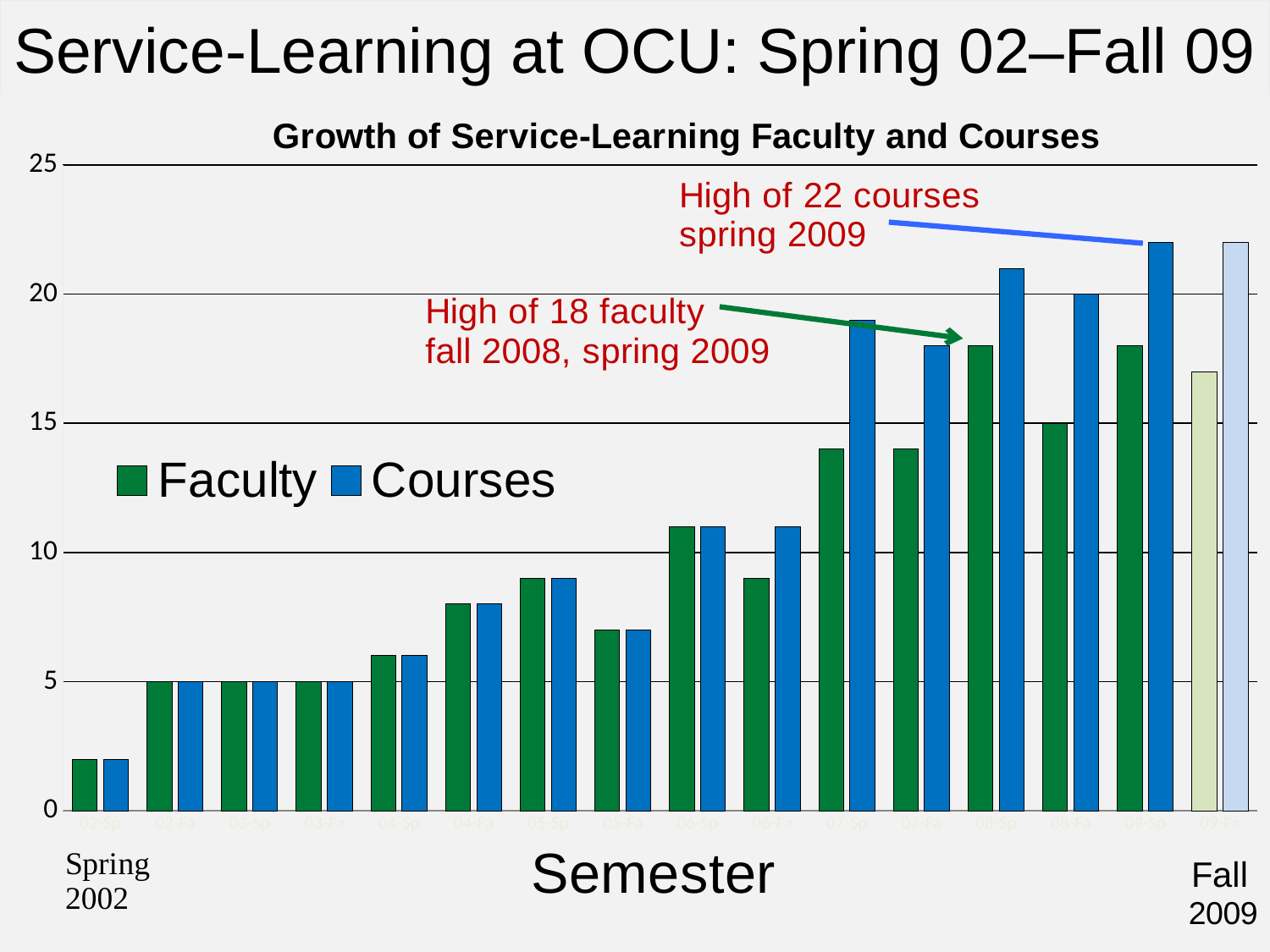
How many series does the legend list? 2 What is the difference between the high of 22 courses and the high of 18 faculty? 4 Which series is shown in green in the legend? Faculty What is the title of the chart? Growth of Service-Learning Faculty and Courses Which semester has the lowest values for both faculty and courses? Spring 2002 Is the Courses value for Spring 2002 greater or less than 5? less What is the highest number of faculty reached, according to the annotation? 18 In which semester did courses reach their high of 22? spring 2009 Overall, do the values rise or fall from Spring 2002 to Fall 2009? rise What kind of chart is shown on the slide? bar chart What is the highest number of courses reached, according to the annotation? 22 In spring 2009, which is larger, the number of faculty or the number of courses? Courses